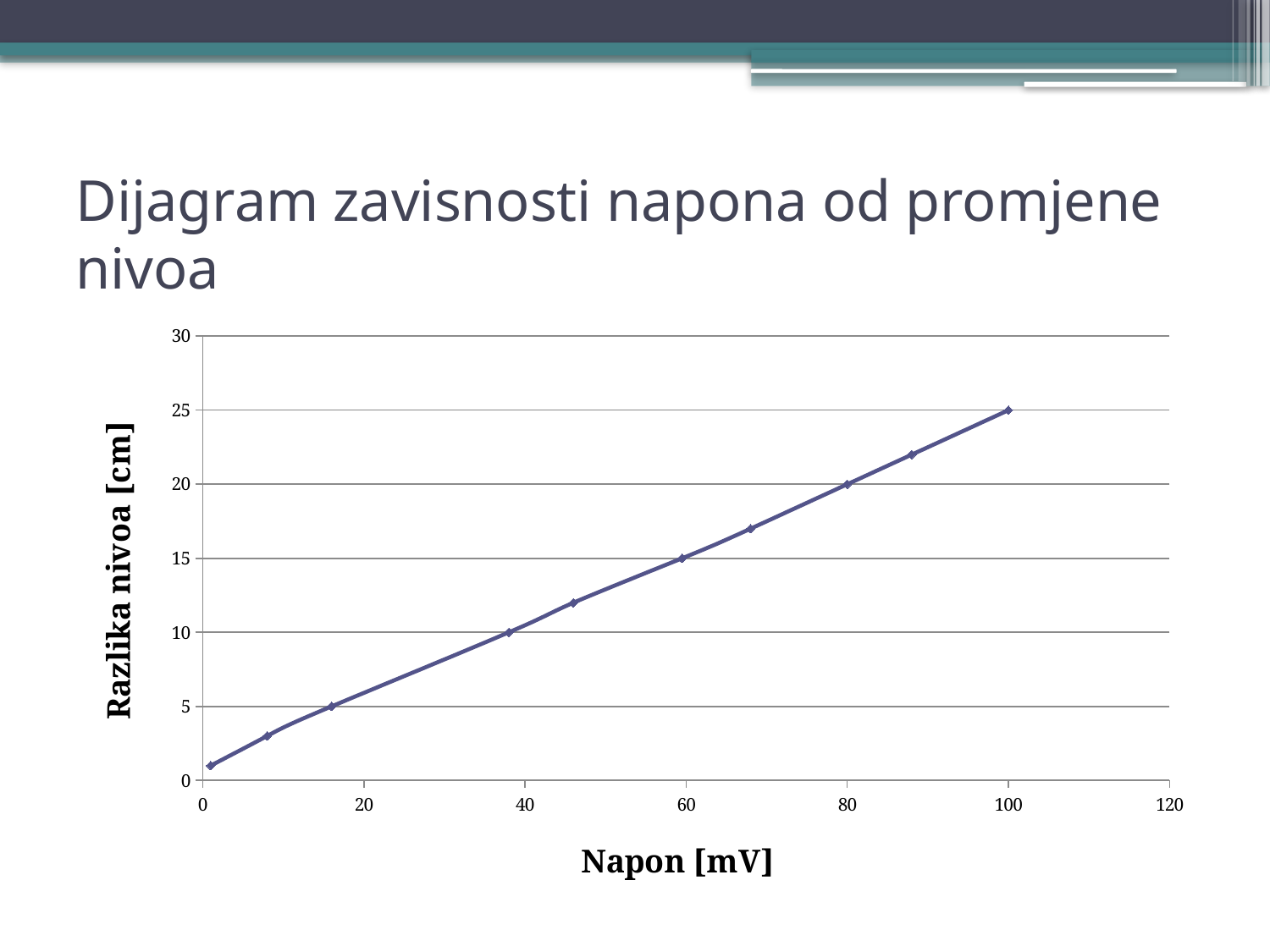
What is the level difference (Razlika nivoa) at a voltage of 100 mV? 25 What is the level difference (Razlika nivoa) at a voltage of 80 mV? 20 What is the difference between the level difference at 100 mV and at 80 mV? 5 What is the title of the y axis of the chart? Razlika nivoa [cm] What kind of chart is shown on the slide? line chart Which voltage gives the larger level difference, 80 mV or 100 mV? 100 mV Is the level difference at a voltage of about 46 mV greater or less than 15? less Is the level difference at a voltage of about 88 mV greater or less than 20? greater Do the values rise or fall as the voltage (Napon) increases along the x axis? rise What is the title of the x axis of the chart? Napon [mV] What is the highest level difference value reached on the chart? 25 How many data points are plotted on the chart? 10